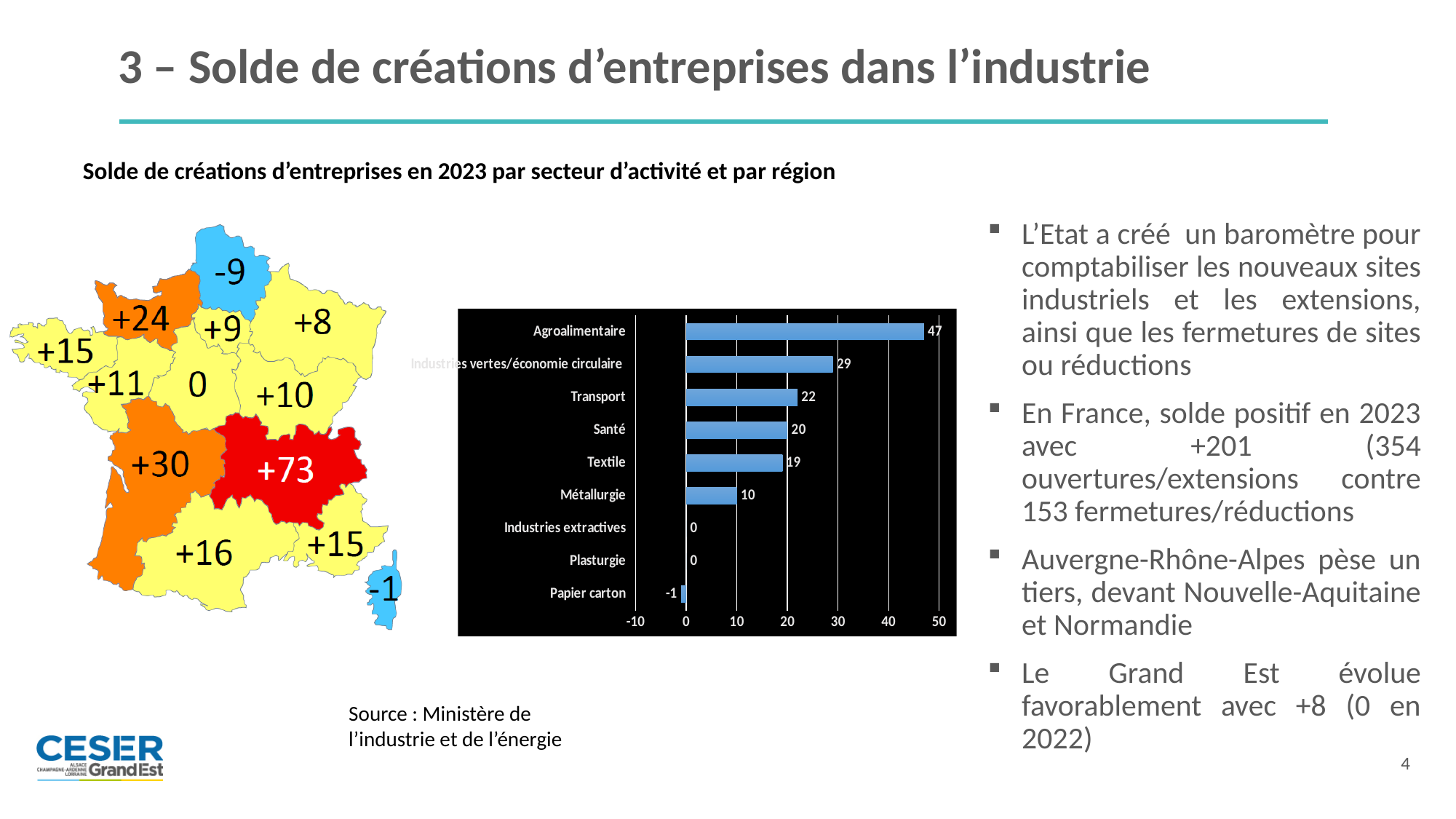
In the bar chart, which sector has the highest value? Agroalimentaire In the bar chart, what is the value for Agroalimentaire? 47 In the bar chart, what is the value for Métallurgie? 10 In the bar chart, what is the value for Transport? 22 In the bar chart, what is the difference between Agroalimentaire and Industries vertes/économie circulaire? 18 In the bar chart, which sector has the lowest value? Papier carton How many sectors are shown in the bar chart? 9 In the bar chart, what is the value for Papier carton? -1 In the bar chart, how many sectors have a value of 0? 2 What kind of chart is used to show the values by sector? Bar chart In the bar chart, which is larger, Santé or Textile? Santé